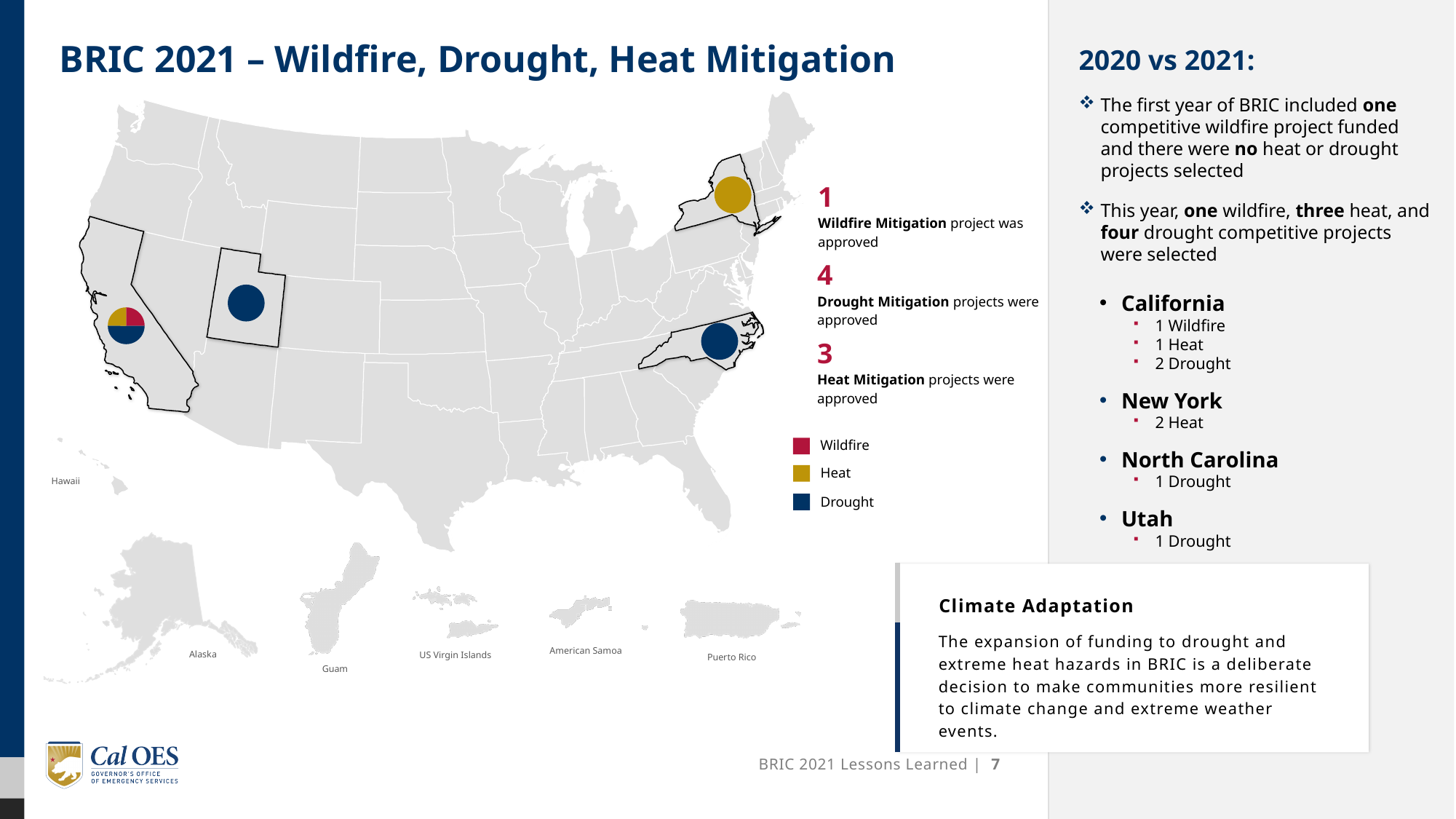
How many Drought Mitigation projects were approved according to the map? 4 Which mitigation type had the fewest approved projects? Wildfire Mitigation How many Wildfire Mitigation projects were approved according to the map? 1 Were more Heat Mitigation or Drought Mitigation projects approved? Drought Mitigation What kind of chart is shown on the slide? Pie charts placed on a map of the United States Which three categories are listed in the map legend? Wildfire, Heat, Drought How many categories does the map legend list? 3 What is the total number of approved projects across Wildfire, Drought and Heat Mitigation shown on the map? 8 Which mitigation type had the most approved projects? Drought Mitigation How many more Drought Mitigation projects than Wildfire Mitigation projects were approved? 3 How many Heat Mitigation projects were approved according to the map? 3 How many states are marked with project circles on the map? 4